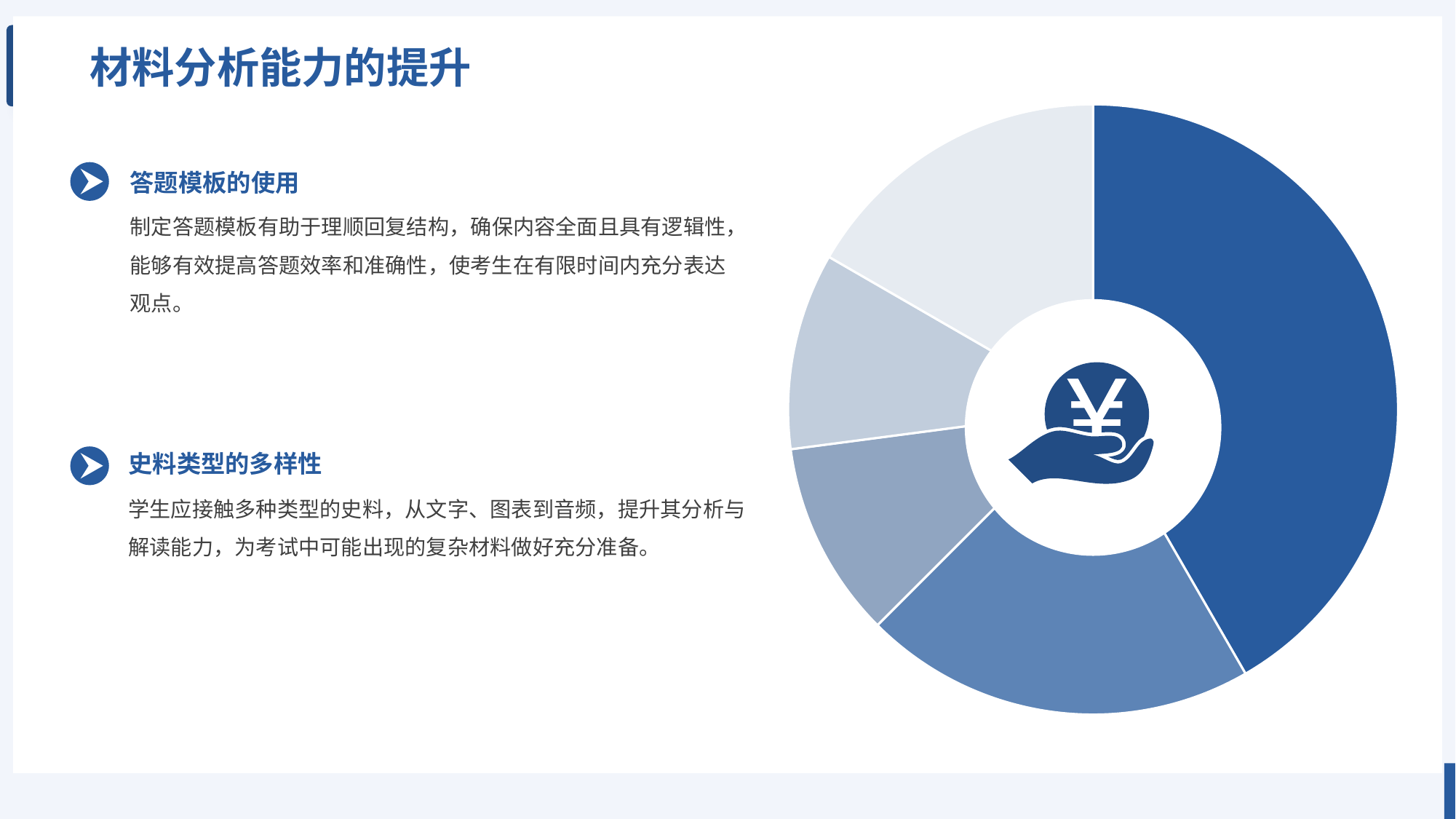
What symbol appears in the centre of the pie chart? A ¥ (yuan) coin held in a hand What kind of chart is shown on the right side of the slide? Pie chart (donut) Does the pie chart on the slide show any data labels or values on its slices? No How many slices does the pie chart on the right of the slide have? 5 Which slice of the pie chart is the largest? The dark blue slice on the right